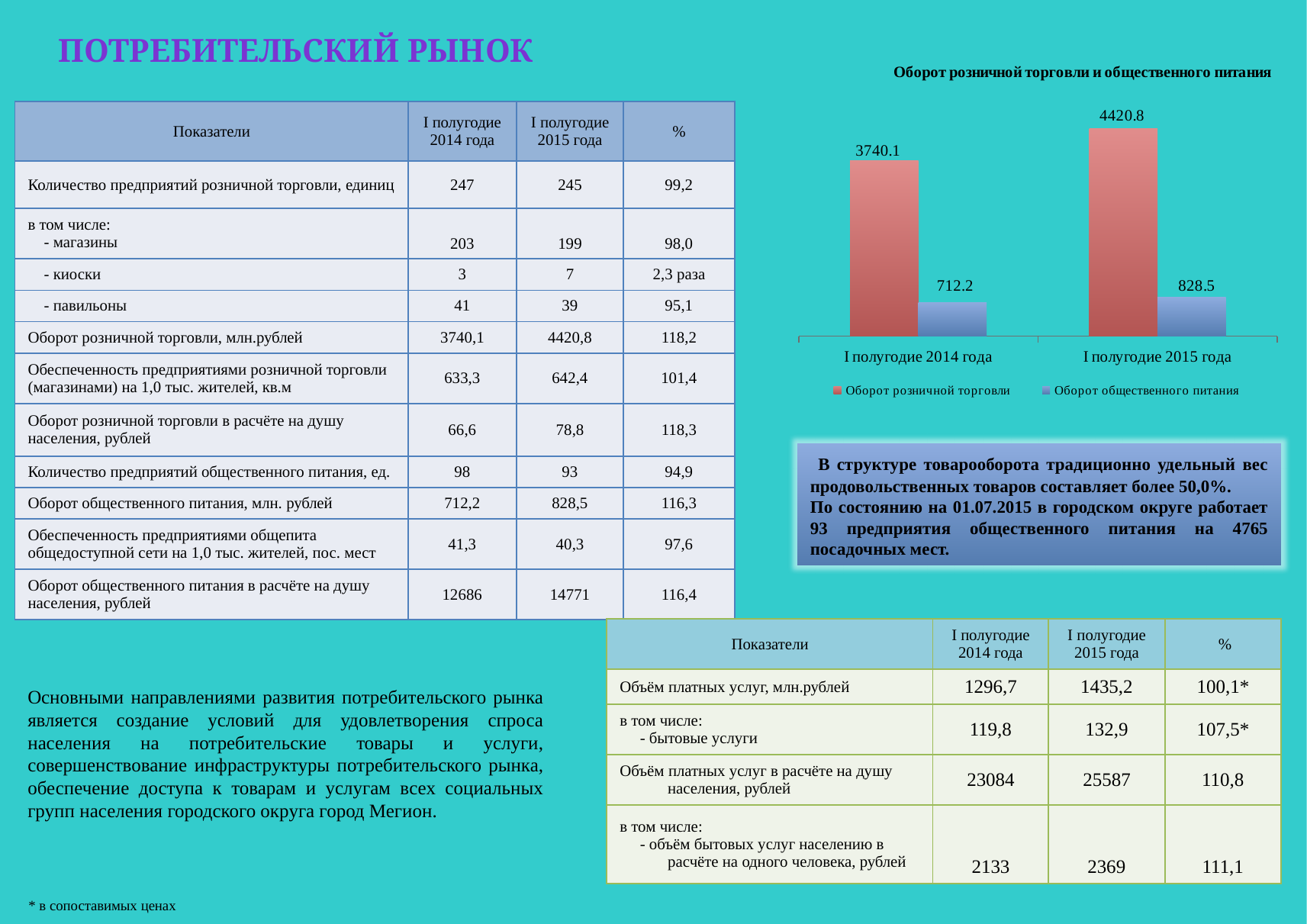
By how much did Оборот розничной торговли increase from I полугодие 2014 года to I полугодие 2015 года in the chart? 680.7 In I полугодие 2015 года, which is larger in the chart: Оборот розничной торговли or Оборот общественного питания? Оборот розничной торговли What is the value of Оборот общественного питания for I полугодие 2015 года in the chart? 828.5 What is the value of Оборот общественного питания for I полугодие 2014 года in the chart? 712.2 What is the value of Оборот розничной торговли for I полугодие 2015 года in the chart? 4420.8 What is the difference between Оборот общественного питания in I полугодие 2015 года and I полугодие 2014 года in the chart? 116.3 How many series does the chart legend list? 2 Which period has the higher value of Оборот розничной торговли in the chart? I полугодие 2015 года What is the value of Оборот розничной торговли for I полугодие 2014 года in the chart? 3740.1 What is the title of the chart on the slide? Оборот розничной торговли и общественного питания Which period has the lower value of Оборот общественного питания in the chart? I полугодие 2014 года What type of chart is shown on the slide? Bar chart